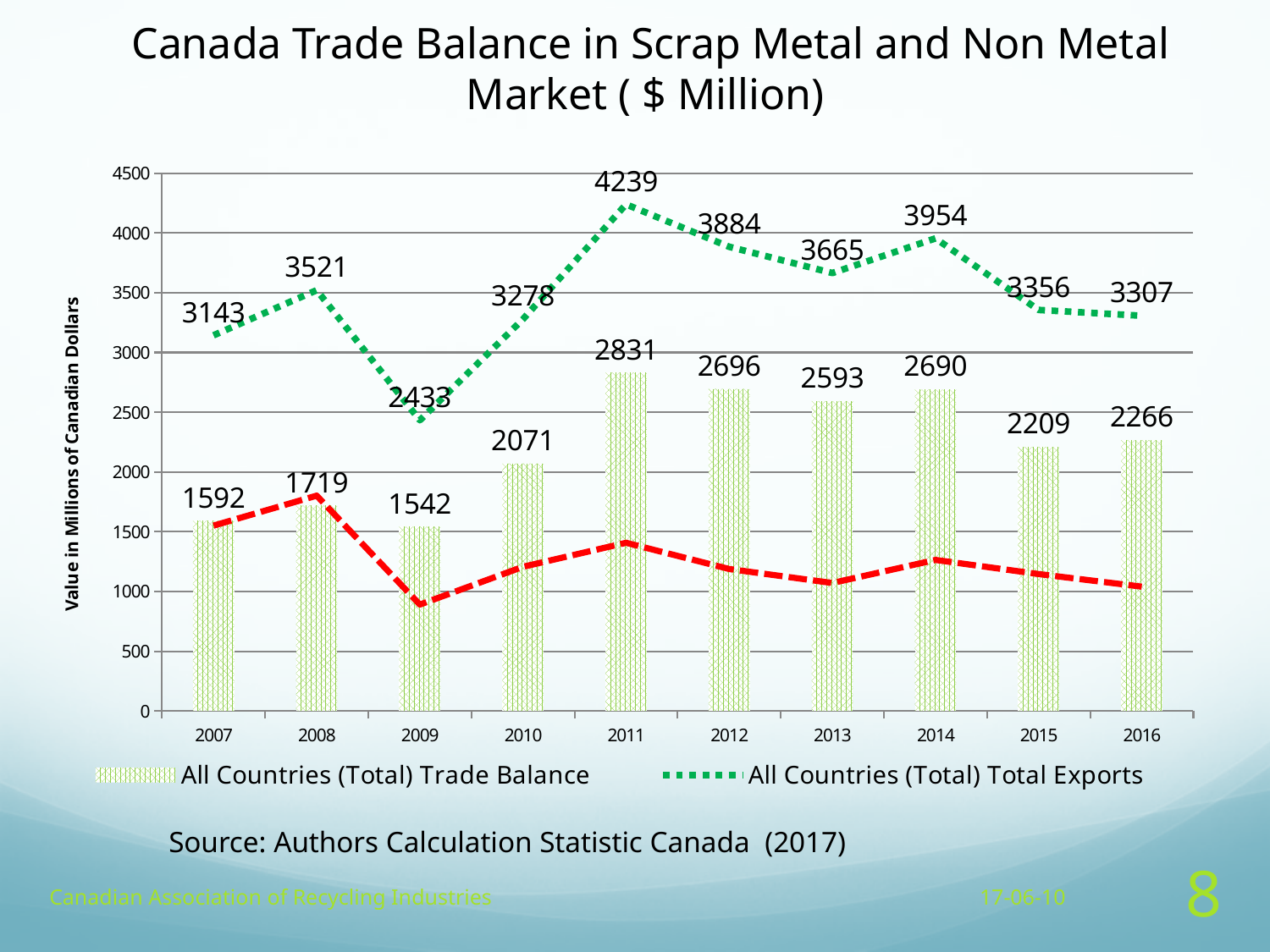
Which year has the larger Trade Balance value, 2012 or 2013? 2012 How many series does the legend list? 2 Is the Total Exports value for 2008 greater or less than 3500? greater What is the All Countries (Total) Trade Balance value for 2011? 2831 Did the Trade Balance value rise or fall from 2014 to 2015? Fall How many years are shown on the x axis? 10 What kind of chart is this? Combined bar and line chart In which year is the All Countries (Total) Trade Balance value lowest? 2009 What is the All Countries (Total) Total Exports value for 2009? 2433 In which year is the All Countries (Total) Total Exports value highest? 2011 What is the All Countries (Total) Trade Balance value for 2016? 2266 What is the difference between the Total Exports value and the Trade Balance value in 2014? 1264